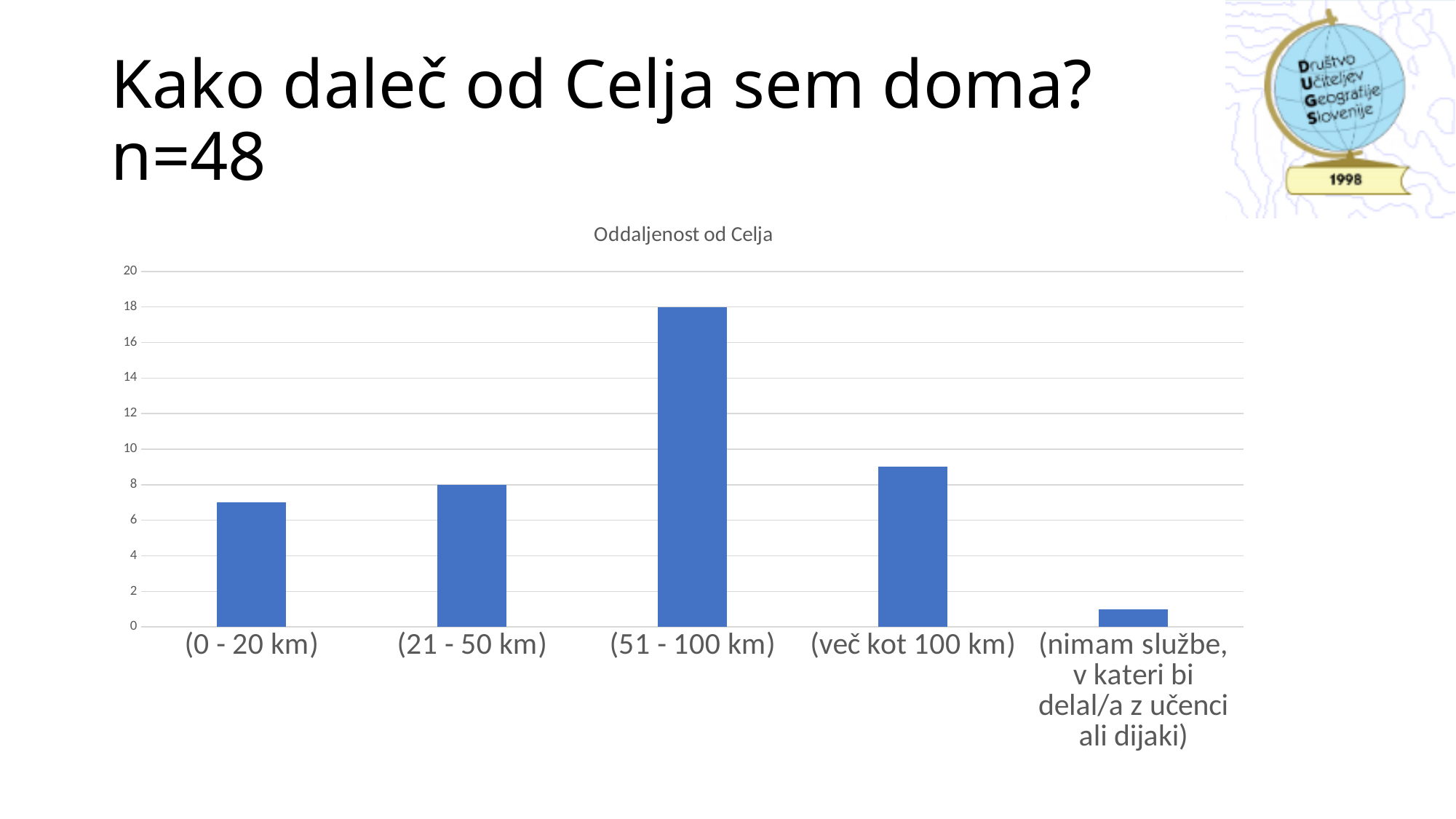
Which category has the highest value? (51 - 100 km) What is the value for (51 - 100 km)? 18 Which category has the lowest value? (nimam službe, v kateri bi delal/a z učenci ali dijaki) Is the value for (nimam službe, v kateri bi delal/a z učenci ali dijaki) greater or less than 2? less What is the value for (21 - 50 km)? 8 What is the difference between the values for (51 - 100 km) and (21 - 50 km)? 10 Which is larger, the value for (51 - 100 km) or the value for (več kot 100 km)? (51 - 100 km) What type of chart is shown on the slide? bar chart Is the value for (več kot 100 km) greater or less than 10? less How many categories are shown on the x axis of the chart? 5 What is the title of the chart? Oddaljenost od Celja Is the value for (0 - 20 km) greater or less than 6? greater